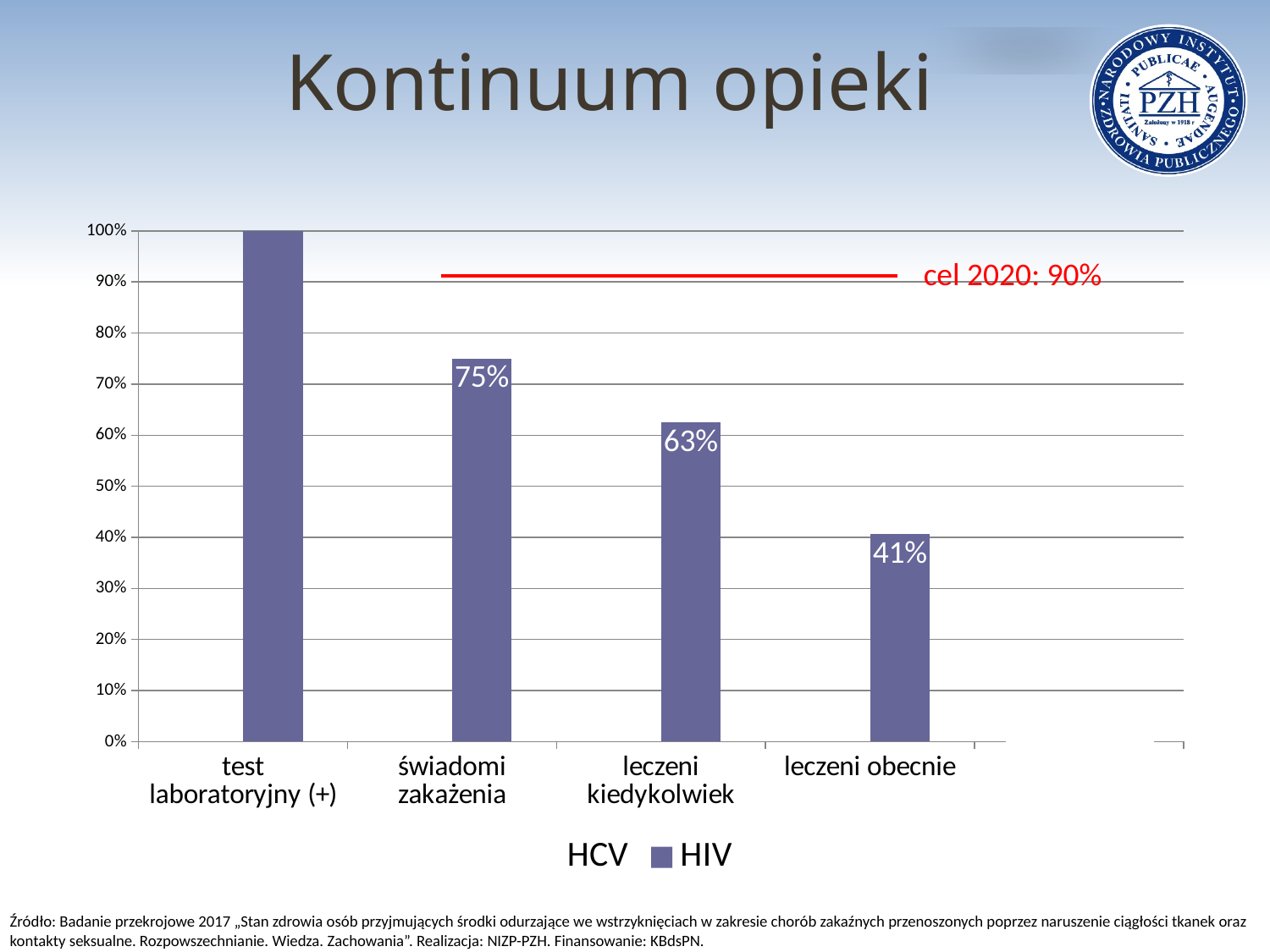
Which is larger, 'leczeni kiedykolwiek' or 'leczeni obecnie'? leczeni kiedykolwiek Do the values rise or fall from left to right along the x axis? fall What kind of chart is shown? bar chart What is the value for 'świadomi zakażenia'? 75% What is the value for 'test laboratoryjny (+)'? 100% Which category has the highest value? test laboratoryjny (+) How many categories are shown on the x axis? 4 What is the difference between 'świadomi zakażenia' and 'leczeni obecnie'? 34% What is the value for 'leczeni kiedykolwiek'? 63% What is the value for 'leczeni obecnie'? 41% Which category has the lowest value? leczeni obecnie How many series does the legend list? 2